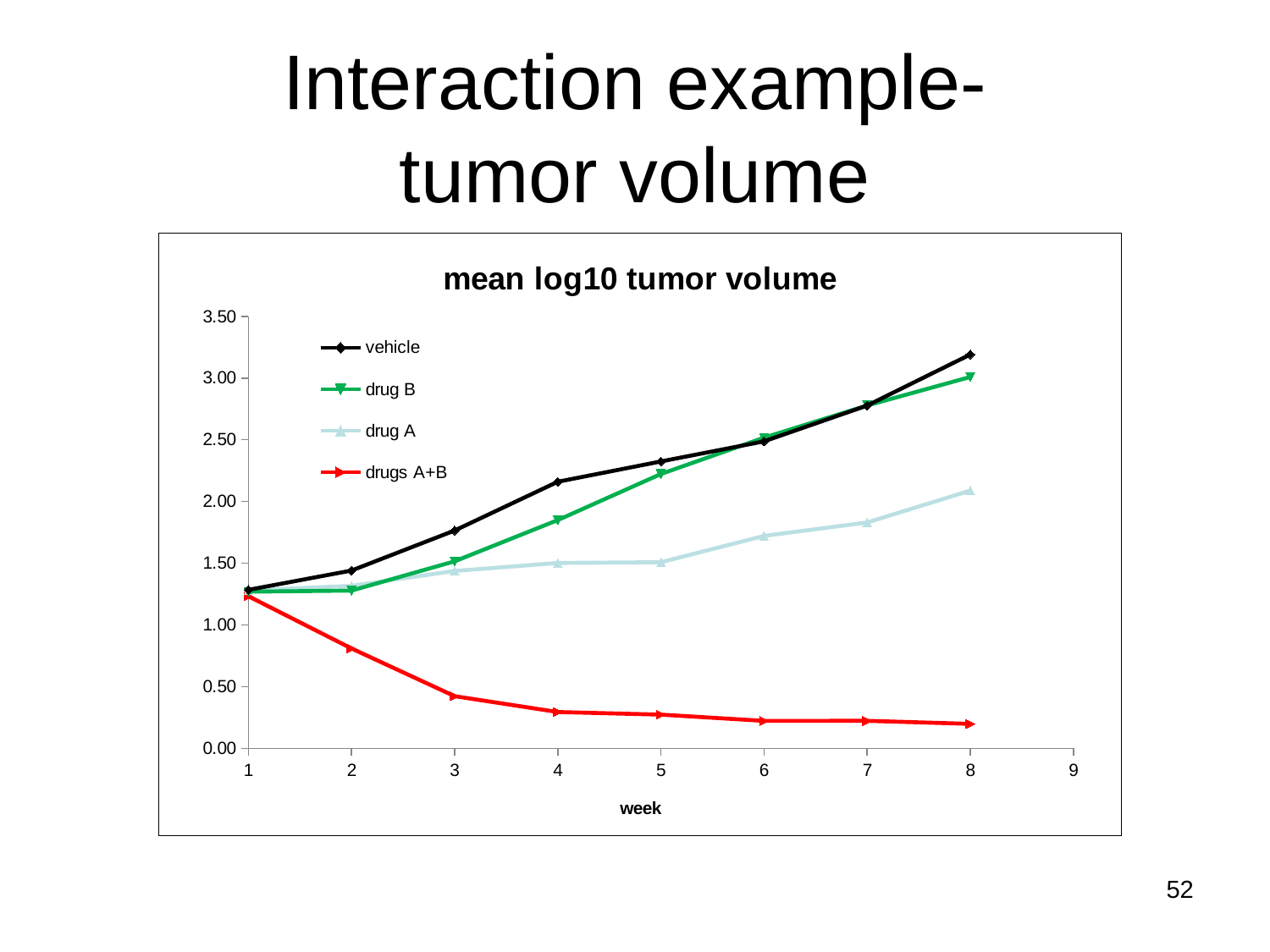
Does the drugs A+B series rise or fall from week 1 to week 8? fall Is the value for drugs A+B at week 8 greater or less than 0.50? less At week 4, which is larger: the value for vehicle or the value for drug B? vehicle What kind of chart is shown on the slide? line chart Which series has the highest value at week 8? vehicle Is the value for vehicle at week 8 greater or less than 3.00? greater How many series does the legend list? 4 How many weeks have data points plotted for the vehicle series? 8 What is the label of the x axis? week Which series has the lowest value at week 8? drugs A+B What is the title of the chart? mean log10 tumor volume Does the vehicle series rise or fall from week 1 to week 8? rise